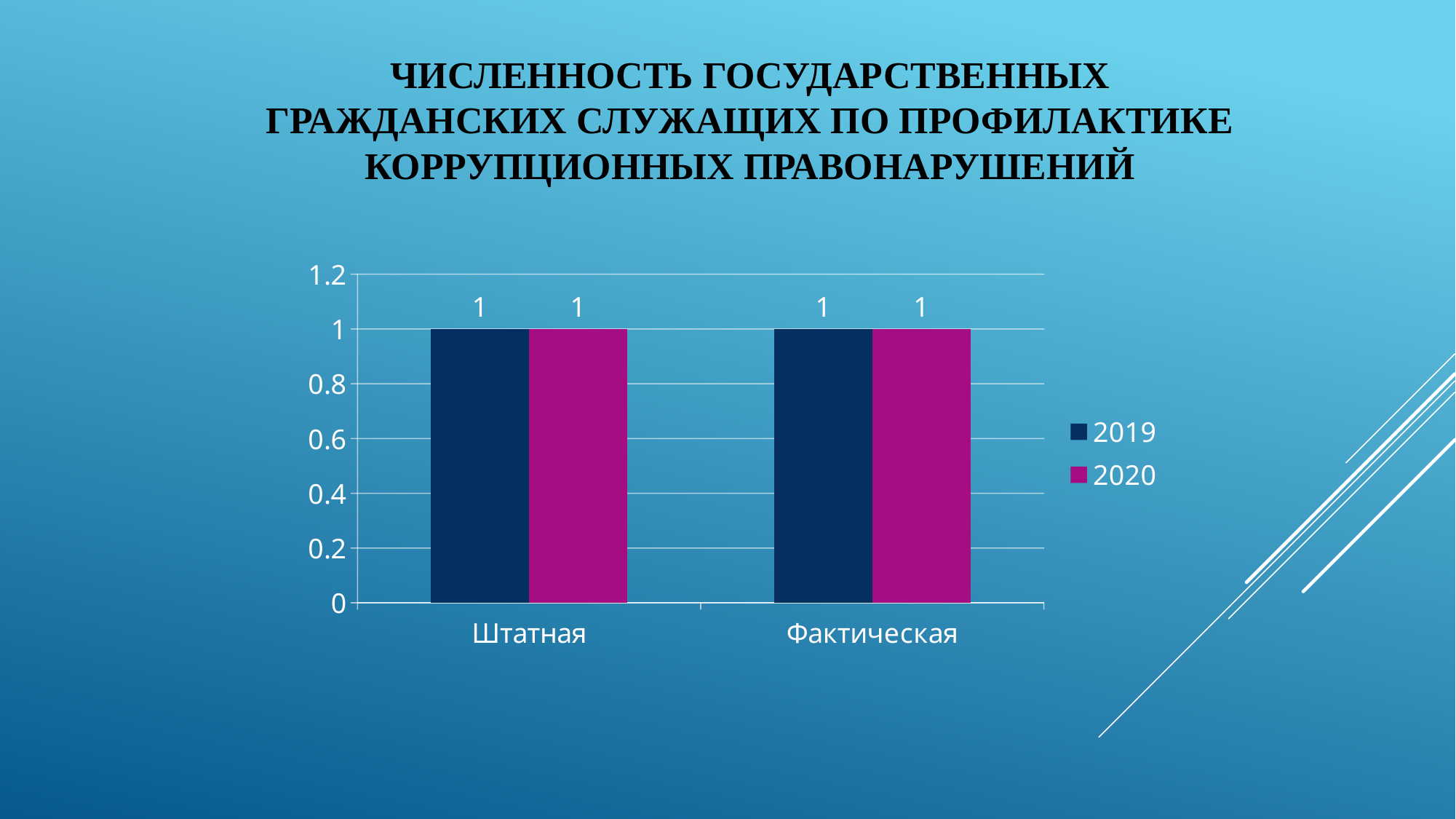
How many series does the legend list? 2 What is the highest value shown on the vertical axis? 1.2 What is the value for Штатная in 2019? 1 What kind of chart is shown on the slide? bar chart Which series does the magenta bar represent? 2020 What is the value for Штатная in 2020? 1 What is the value for Фактическая in 2019? 1 What is the difference between the Штатная and Фактическая values for 2020? 0 How many categories are shown on the x axis? 2 What is the value for Фактическая in 2020? 1 Is the value for Штатная in 2019 greater or less than 0.8? greater What is the difference between the 2019 and 2020 values for Штатная? 0